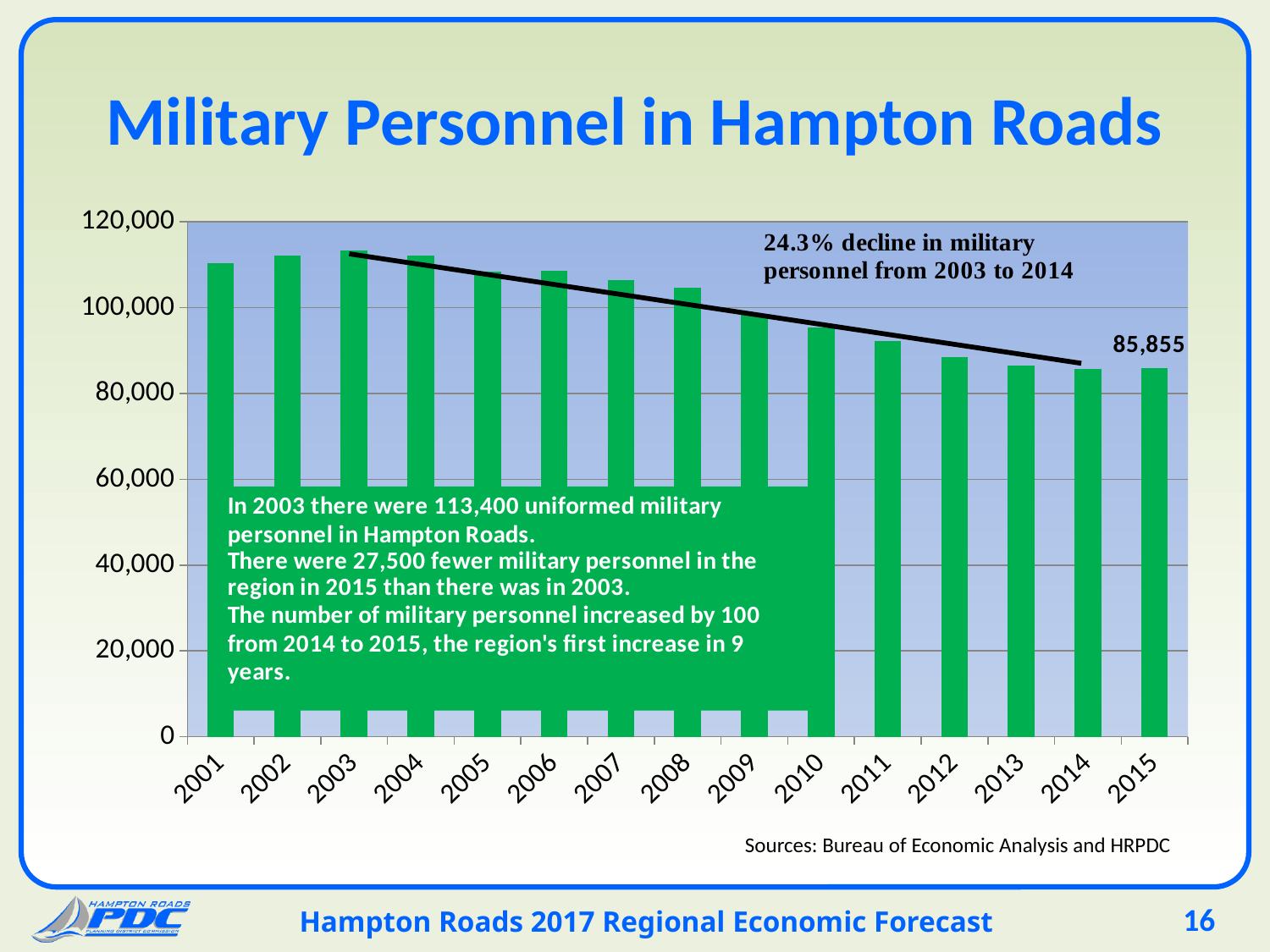
How many fewer military personnel were there in 2015 than in 2003, according to the chart text? 27,500 What is the value for 2015 in the chart? 85,855 Is the value for 2001 greater or less than 100,000? greater How many years are plotted on the x axis of the chart? 15 Which is larger, the value for 2001 or the value for 2013? 2001 What kind of chart is shown on the slide? bar chart According to the text on the chart, how many uniformed military personnel were in Hampton Roads in 2003? 113,400 Is the value for 2011 greater or less than 100,000? less What percentage decline in military personnel from 2003 to 2014 does the chart annotation state? 24.3% Is the value for 2012 greater or less than 80,000? greater Do the values generally rise or fall from 2003 to 2014? fall Which year has the highest bar in the chart? 2003